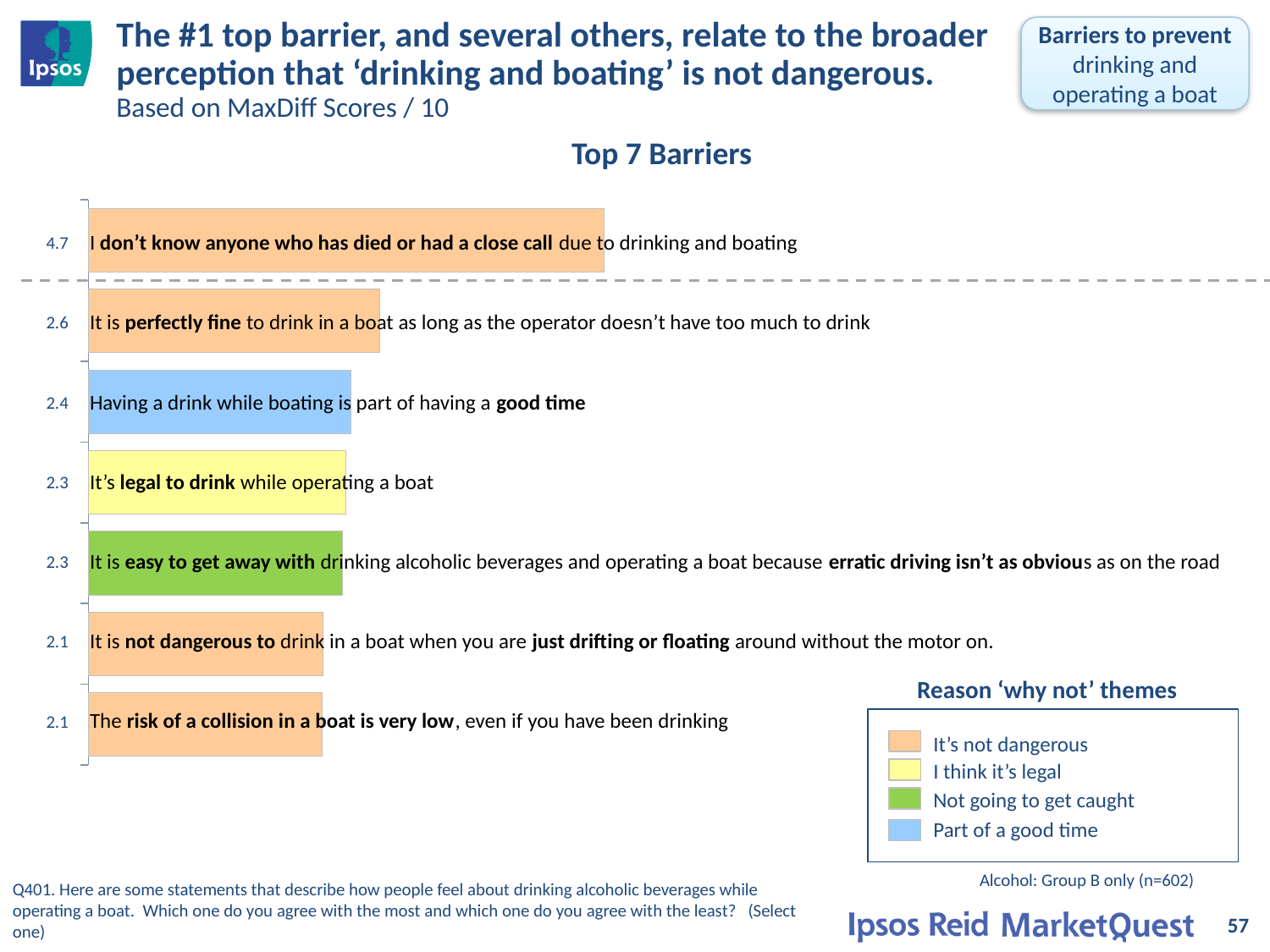
What is the difference between the top barrier's score (4.7) and the second barrier's score (2.6)? 2.1 What is the score for "It's legal to drink while operating a boat"? 2.3 How many barriers are shown in the chart? 7 What is the MaxDiff score for "I don't know anyone who has died or had a close call due to drinking and boating"? 4.7 How many 'why not' themes are listed in the legend? 4 What is the score for "It is perfectly fine to drink in a boat as long as the operator doesn't have too much to drink"? 2.6 Which theme does the green bar represent? Not going to get caught What type of chart is used to show the Top 7 Barriers? Bar chart What is the score for "The risk of a collision in a boat is very low, even if you have been drinking"? 2.1 What is the score for "Having a drink while boating is part of having a good time"? 2.4 Which barrier has the highest MaxDiff score? I don't know anyone who has died or had a close call due to drinking and boating Which has a higher score: "Having a drink while boating is part of having a good time" or "It is perfectly fine to drink in a boat as long as the operator doesn't have too much to drink"? It is perfectly fine to drink in a boat as long as the operator doesn't have too much to drink